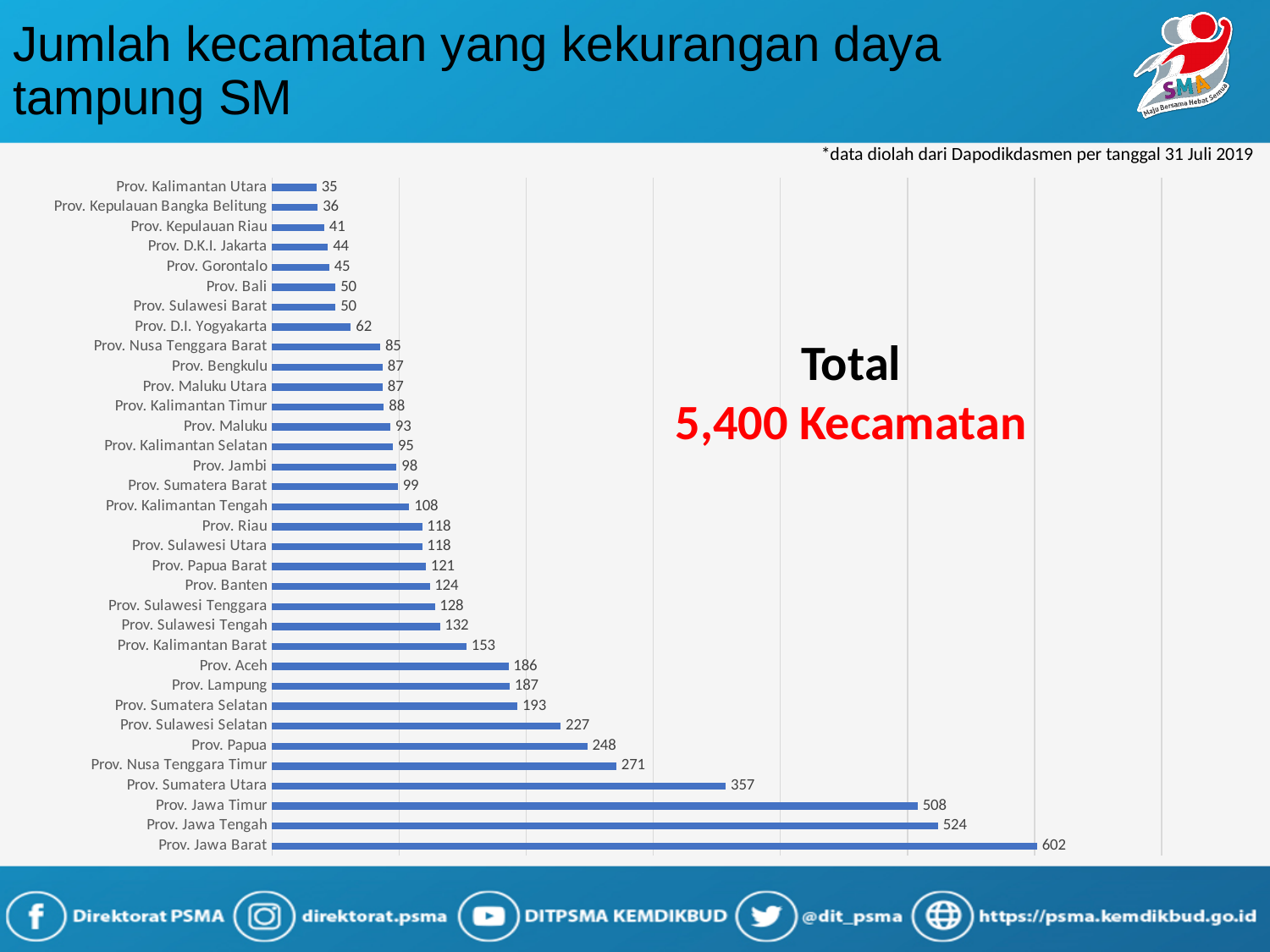
What is the value for Prov. Jawa Barat? 602 What is the difference between the values for Prov. Papua and Prov. Sulawesi Selatan? 21 What is the value for Prov. Sumatera Utara? 357 Which province has the lowest value? Prov. Kalimantan Utara What is the value for Prov. Kalimantan Barat? 153 What total is stated in the text next to the chart? 5,400 Kecamatan How many provinces are shown in the chart? 34 What is the difference between the values for Prov. Jawa Tengah and Prov. Jawa Timur? 16 Which is larger, the value for Prov. Nusa Tenggara Timur or the value for Prov. Lampung? Prov. Nusa Tenggara Timur What is the value for Prov. D.I. Yogyakarta? 62 What kind of chart is shown on the slide? Bar chart Which province has the highest value? Prov. Jawa Barat